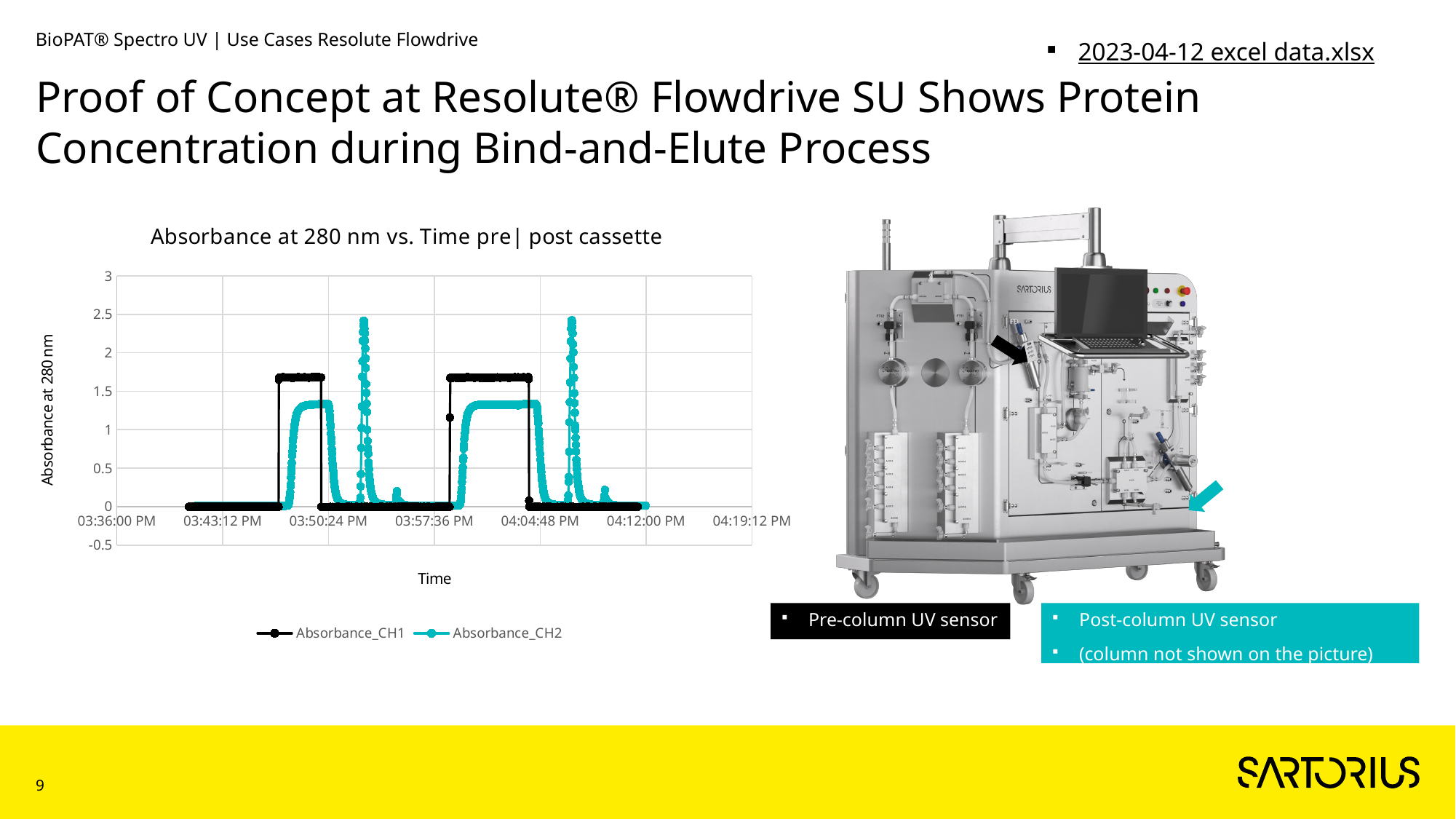
Is the highest peak of Absorbance_CH2 greater or less than 2? greater How many series does the chart legend list? 2 What is the first time label shown on the x axis of the chart? 03:36:00 PM What are the names of the two series in the chart legend? Absorbance_CH1 and Absorbance_CH2 What is the highest value shown on the y axis of the chart? 3 Which series reaches the higher maximum absorbance, Absorbance_CH1 or Absorbance_CH2? Absorbance_CH2 Which series has the higher plateau level, Absorbance_CH1 or Absorbance_CH2? Absorbance_CH1 What is the title of the chart? Absorbance at 280 nm vs. Time pre| post cassette How many plateau steps does the Absorbance_CH1 series show? 2 What kind of chart is shown on the slide? line chart Is the plateau level of Absorbance_CH2 greater or less than 1.5? less Is the plateau level of Absorbance_CH1 greater or less than 1.5? greater